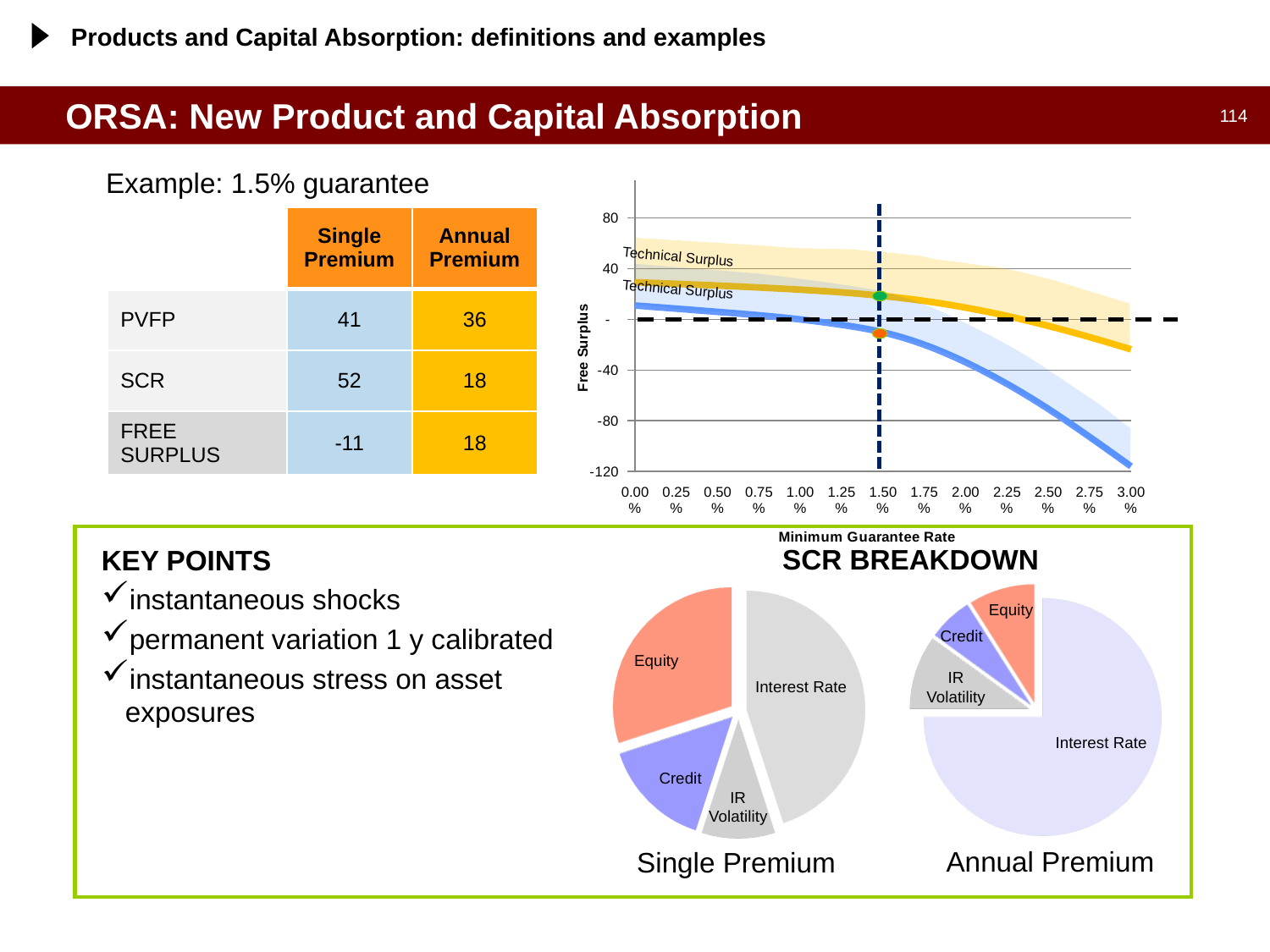
In the Free Surplus line chart, is the value of the blue line at 3.00% greater or less than -80? less In the Free Surplus line chart, at which minimum guarantee rate is the vertical dashed line drawn? 1.50% What kind of charts are used in the SCR BREAKDOWN section? pie charts In the Free Surplus line chart, is the value of the blue line at 3.00% greater or less than the yellow line at 3.00%? less In the Free Surplus line chart, does the blue line rise or fall as the minimum guarantee rate increases? fall In the Single Premium pie chart, how many slices are there? 4 In the Free Surplus line chart, what is the label of the y axis? Free Surplus In the Annual Premium pie chart, which slice is the largest? Interest Rate In the Free Surplus line chart, is the value of the yellow line at 0.00% greater or less than 0? greater In the Single Premium pie chart, which slice is the smallest? IR Volatility In the Free Surplus line chart, how many minimum guarantee rate values are marked on the x axis? 13 What kind of chart is the Free Surplus chart at the top right of the slide? line chart